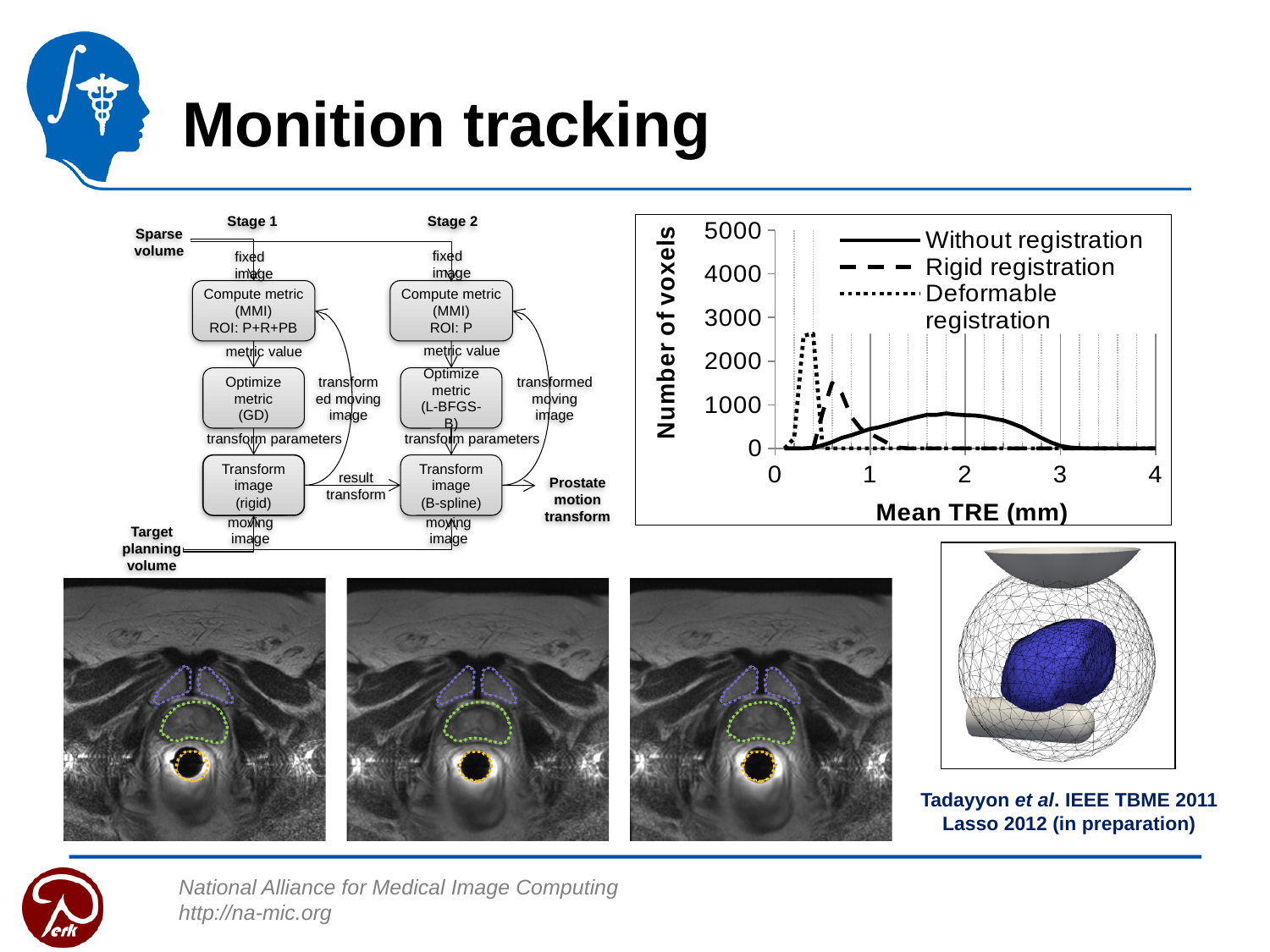
How many series does the chart's legend list? 3 Which series peaks higher, Rigid registration or Without registration? Rigid registration Which series reaches its peak at the largest Mean TRE value? Without registration Which series has the lowest peak in the chart? Without registration Is the peak value of the Rigid registration series greater or less than 2000? less What kind of chart is shown on the slide? line chart Is the peak value of the Without registration series greater or less than 1000? less What is the maximum value shown on the y axis of the chart? 5000 Which series has the highest peak in the chart? Deformable registration What is the title of the y axis of the chart? Number of voxels What is the title of the x axis of the chart? Mean TRE (mm) Is the peak value of the Deformable registration series greater or less than 2000? greater